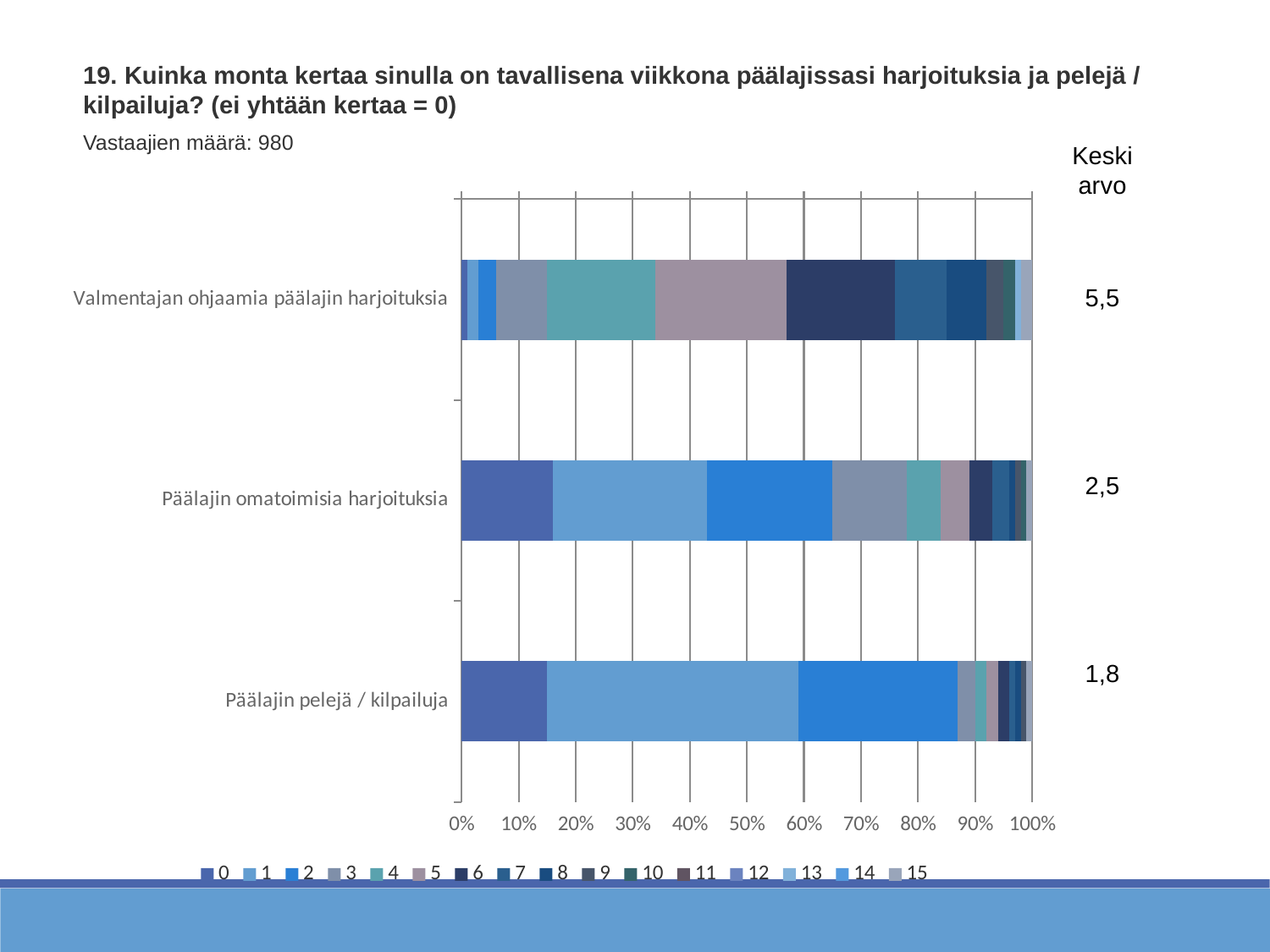
What kind of chart is shown on the slide? Stacked bar chart How many respondents (Vastaajien määrä) are reported on the slide? 980 Which category has the highest Keskiarvo (mean) value? Valmentajan ohjaamia päälajin harjoituksia How many categories (rows) does the chart show? 3 What is the Keskiarvo (mean) shown for Päälajin omatoimisia harjoituksia? 2,5 Which category has the lowest Keskiarvo (mean) value? Päälajin pelejä / kilpailuja Which category has the largest share for the '1' segment? Päälajin pelejä / kilpailuja Is the share of the '0' segment for Päälajin pelejä / kilpailuja greater or less than 20%? less How many series does the legend list? 16 What is the difference between the Keskiarvo values of Valmentajan ohjaamia päälajin harjoituksia and Päälajin pelejä / kilpailuja? 3,7 What is the Keskiarvo (mean) shown for Päälajin pelejä / kilpailuja? 1,8 What is the Keskiarvo (mean) shown for Valmentajan ohjaamia päälajin harjoituksia? 5,5